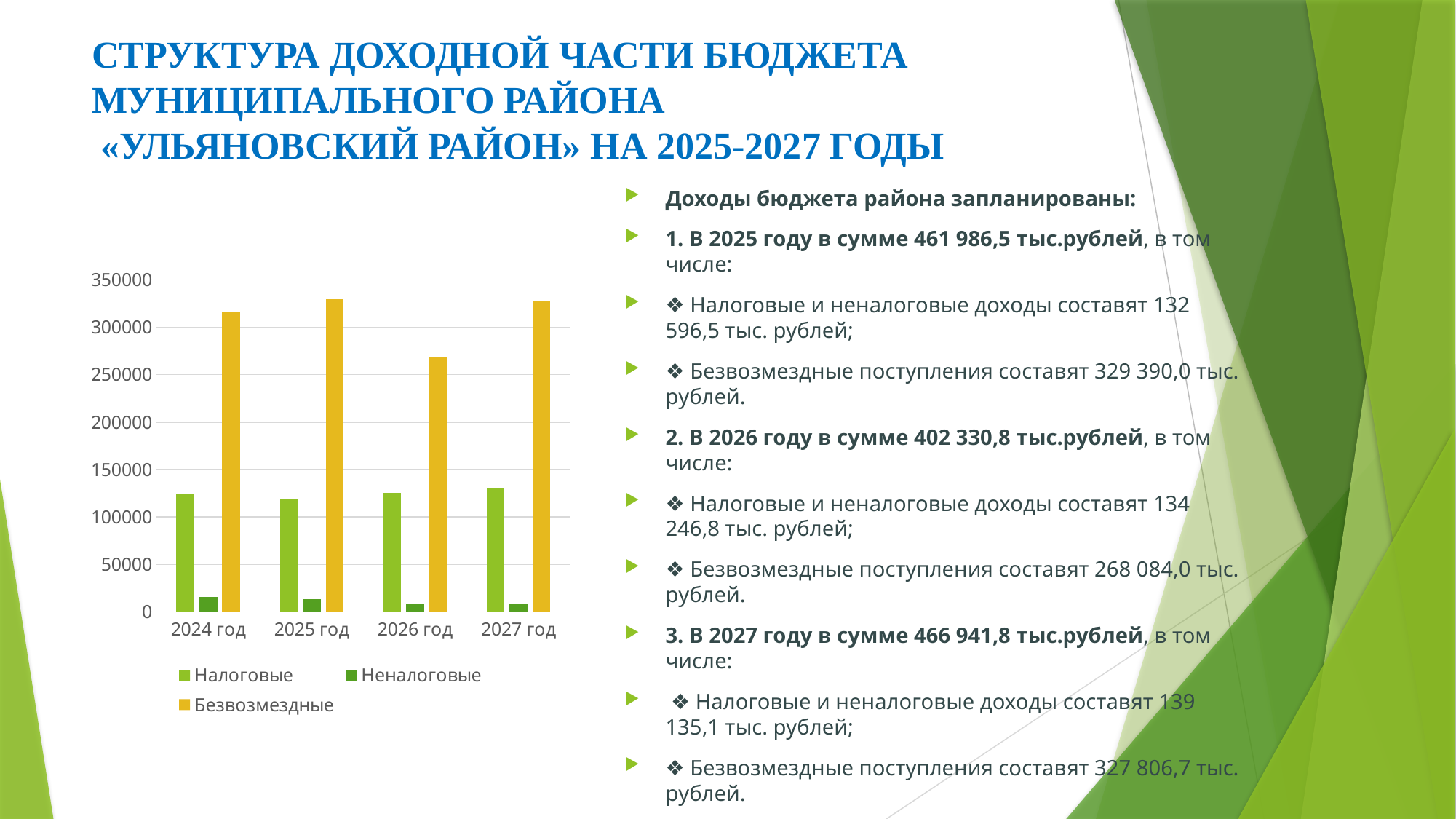
Is the value for Неналоговые in 2027 год greater or less than 50000? less How many series does the chart legend list? 3 Is the value for Безвозмездные in 2025 год greater or less than 300000? greater How many year categories are shown on the x axis of the chart? 4 Is the value for Безвозмездные in 2026 год greater or less than 250000? greater In which year is the Безвозмездные value lowest? 2026 год What kind of chart is shown on the slide? bar chart Which series is shown in yellow in the chart? Безвозмездные Does the Безвозмездные value rise or fall from 2025 год to 2026 год? fall Which is larger in 2024 год: Налоговые or Неналоговые? Налоговые